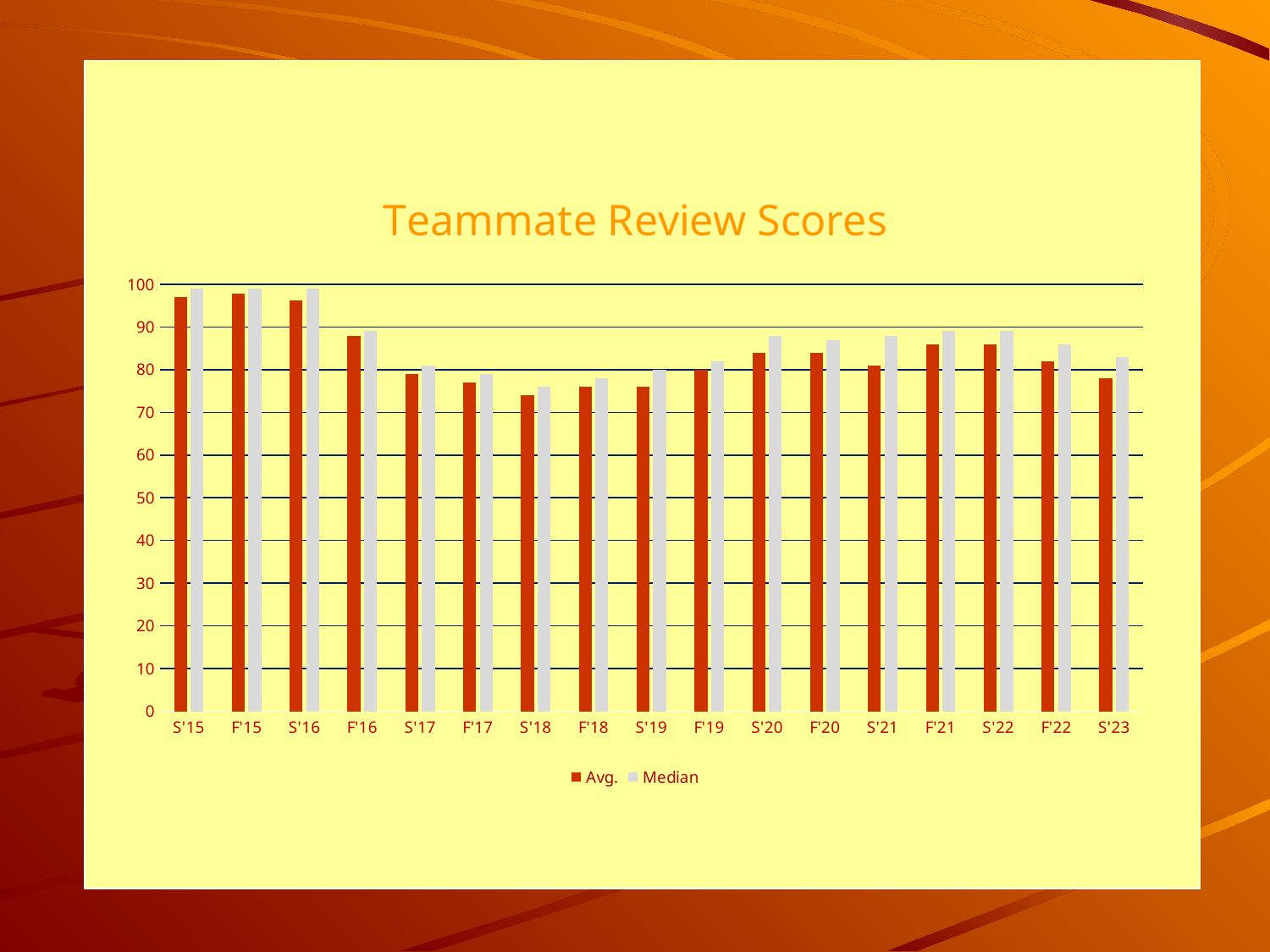
Do the Avg. values rise or fall from S'15 to S'18? fall What kind of chart is shown on the slide? bar chart How many categories are shown on the x axis? 17 Which category has the lowest Median value? S'18 How many series does the legend list? 2 Which category has the lowest Avg. value? S'18 Is the Avg. value for F'17 greater or less than 80? less Which is larger, the Avg. value for F'16 or the Avg. value for S'17? F'16 Is the Avg. value for S'18 greater or less than 80? less Is the Avg. value for S'15 greater or less than 90? greater What is the title of the chart? Teammate Review Scores